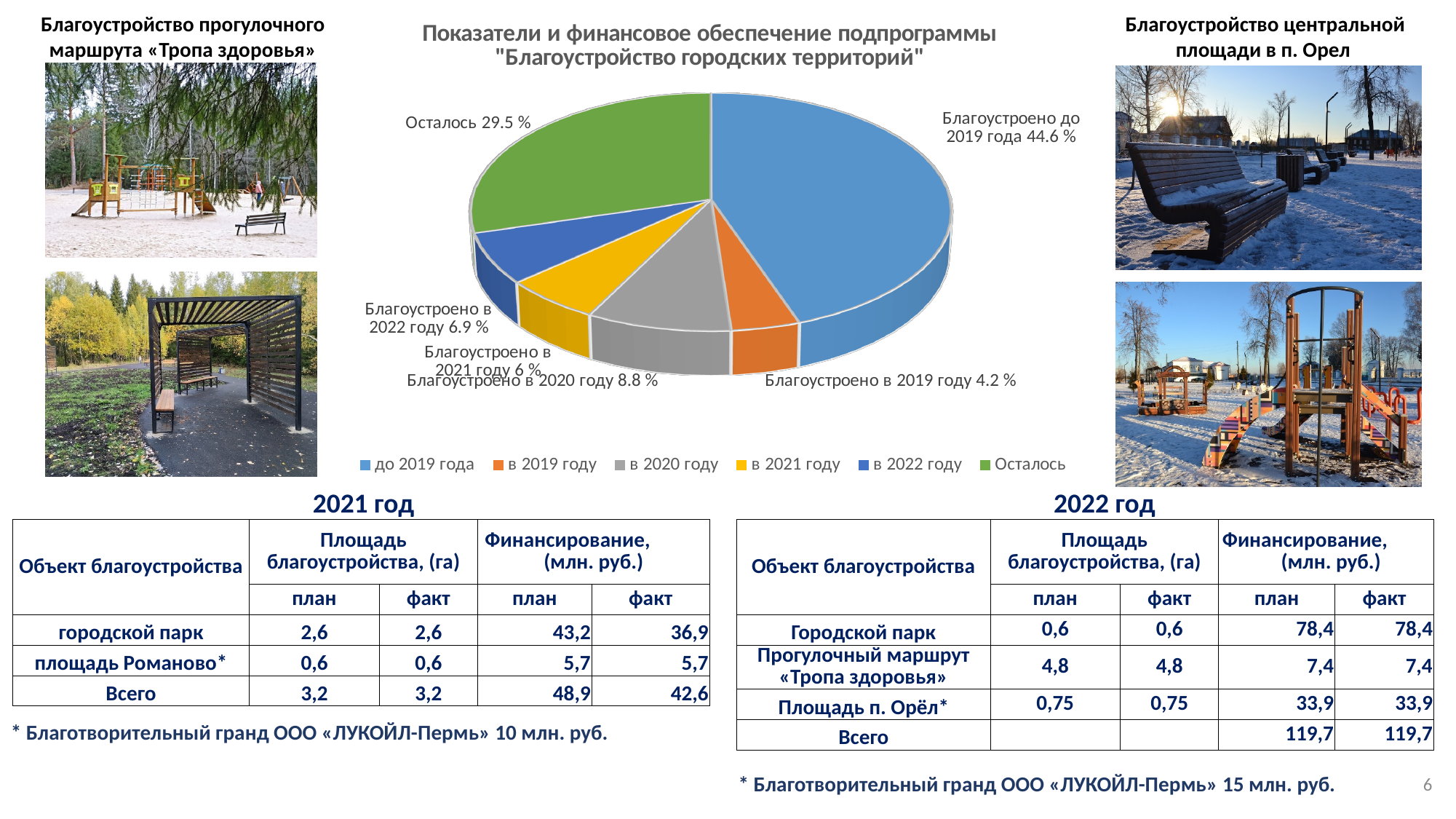
Which slice of the pie chart is the smallest? Благоустроено в 2019 году What kind of chart is shown on the slide? pie chart What share of the pie is labelled "Благоустроено в 2019 году"? 4.2 % What is the difference in percentage points between the "Благоустроено до 2019 года" slice and the "Осталось" slice? 15.1 % What share of the pie is labelled "Благоустроено в 2022 году"? 6.9 % How many slices does the pie chart have? 6 Which slice of the pie chart is the largest? Благоустроено до 2019 года What share of the pie is labelled "Осталось"? 29.5 % Which is larger: the slice for "Благоустроено в 2020 году" or the slice for "Благоустроено в 2021 году"? Благоустроено в 2020 году What share of the pie is labelled "Благоустроено в 2020 году"? 8.8 % What share of the pie is labelled "Благоустроено до 2019 года"? 44.6 % How many entries does the legend of the pie chart list? 6